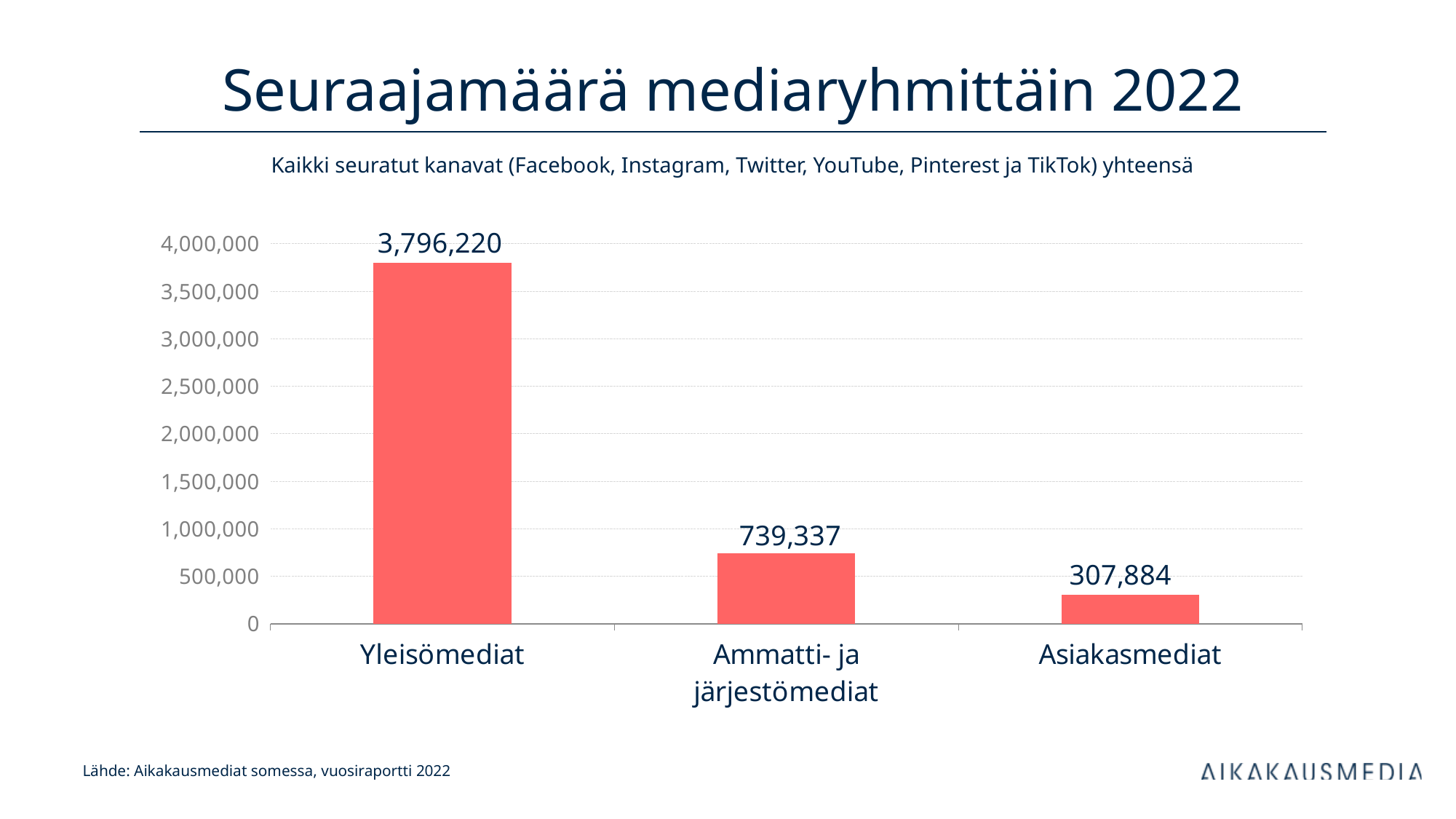
What is the value for Asiakasmediat? 307,884 What is the difference between the values for Yleisömediat and Ammatti- ja järjestömediat? 3,056,883 What is the value for Ammatti- ja järjestömediat? 739,337 What is the value for Yleisömediat? 3,796,220 Which category has the highest value? Yleisömediat Which is larger, the value for Ammatti- ja järjestömediat or the value for Asiakasmediat? Ammatti- ja järjestömediat Is the value for Yleisömediat greater or less than 3,500,000? greater What is the title of the chart? Seuraajamäärä mediaryhmittäin 2022 What is the difference between the values for Ammatti- ja järjestömediat and Asiakasmediat? 431,453 What kind of chart is shown on the slide? bar chart Which category has the lowest value? Asiakasmediat How many categories are shown on the chart? 3